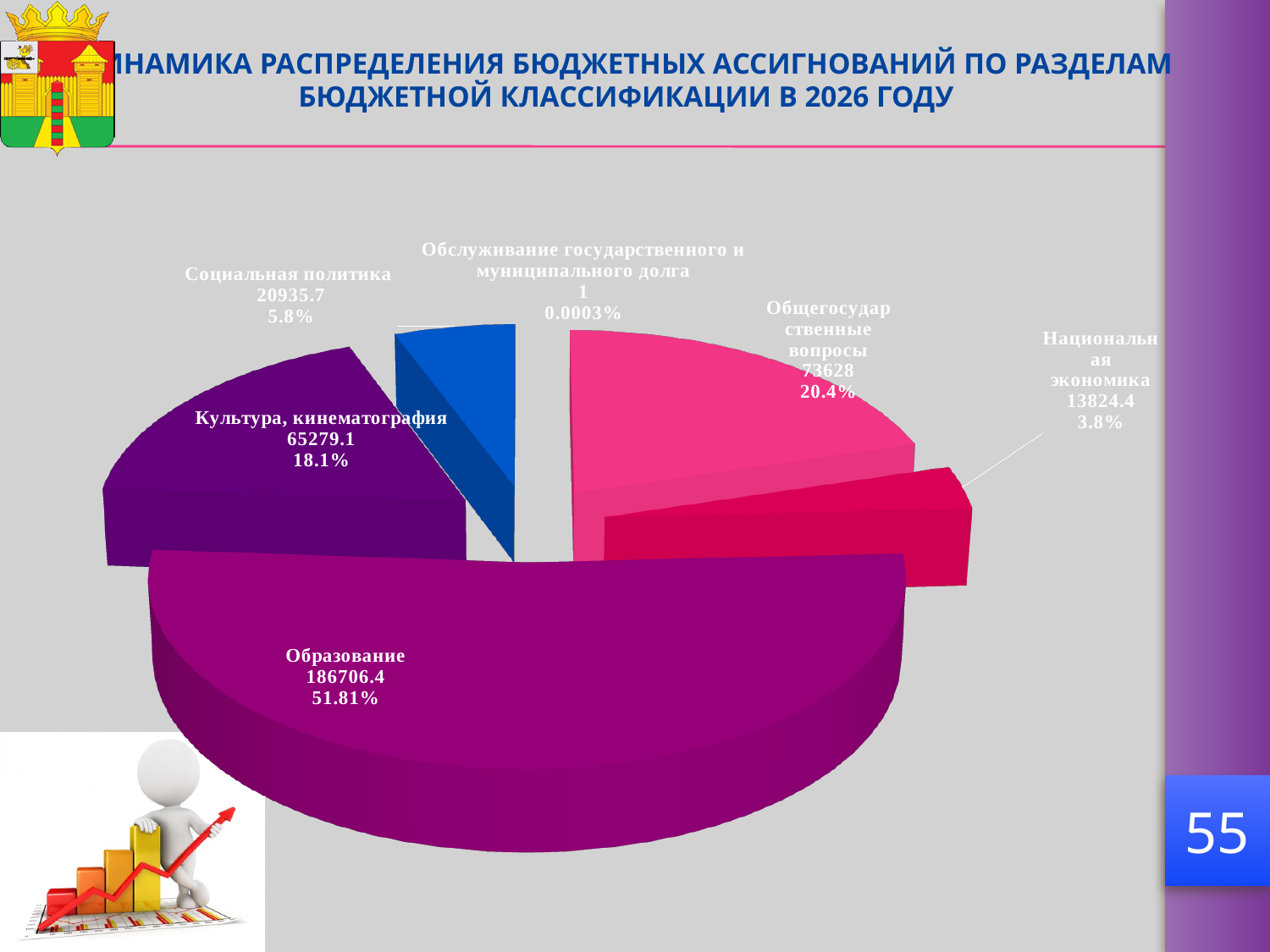
What percentage is shown for Культура, кинематография? 18.1% How many slices does the pie chart have? 6 What percentage is shown for Национальная экономика? 3.8% What share of the pie does Образование represent? 51.81% Which category has the largest share of the pie? Образование Which is larger, the value for Общегосударственные вопросы or the value for Культура, кинематография? Общегосударственные вопросы What type of chart is shown on the slide? pie chart What value is shown for Общегосударственные вопросы? 73628 What value is shown for Образование? 186706.4 Which category has the smallest share of the pie? Обслуживание государственного и муниципального долга What is the difference between the values for Социальная политика and Национальная экономика? 7111.3 What value is shown for Социальная политика? 20935.7